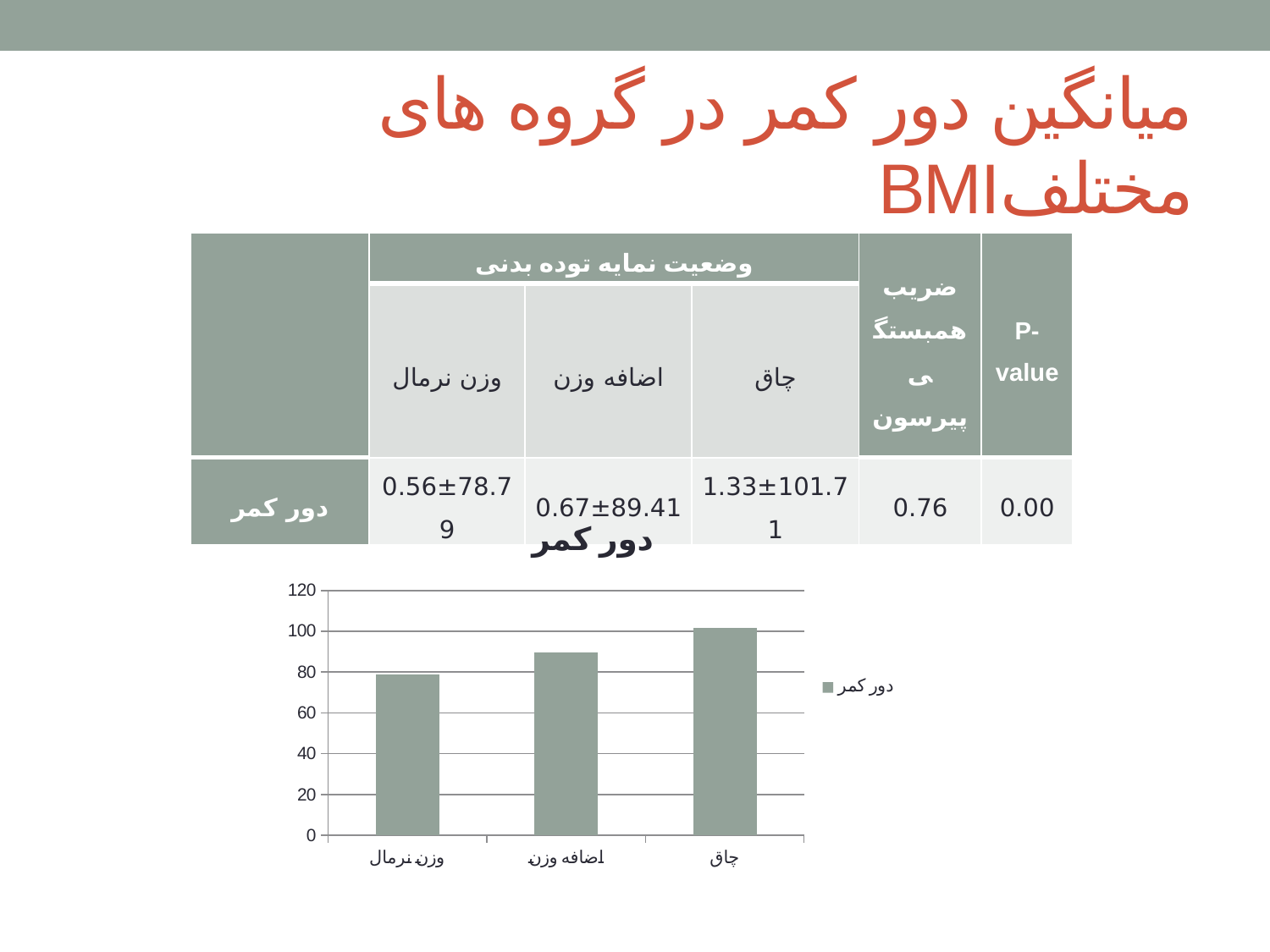
Which category has the lowest bar in the chart? وزن نرمال What is the title of the chart? دور کمر Is the value for وزن نرمال greater or less than 80? less What kind of chart is shown on the slide? bar chart Is the value for اضافه وزن greater or less than 100? less Which category has the highest bar in the chart? چاق How many series does the chart legend list? 1 Do the bar values rise or fall from left to right along the x axis? rise Is the value for چاق greater or less than 100? greater How many categories are shown on the x axis of the chart? 3 Which is larger, the bar for اضافه وزن or the bar for چاق? چاق